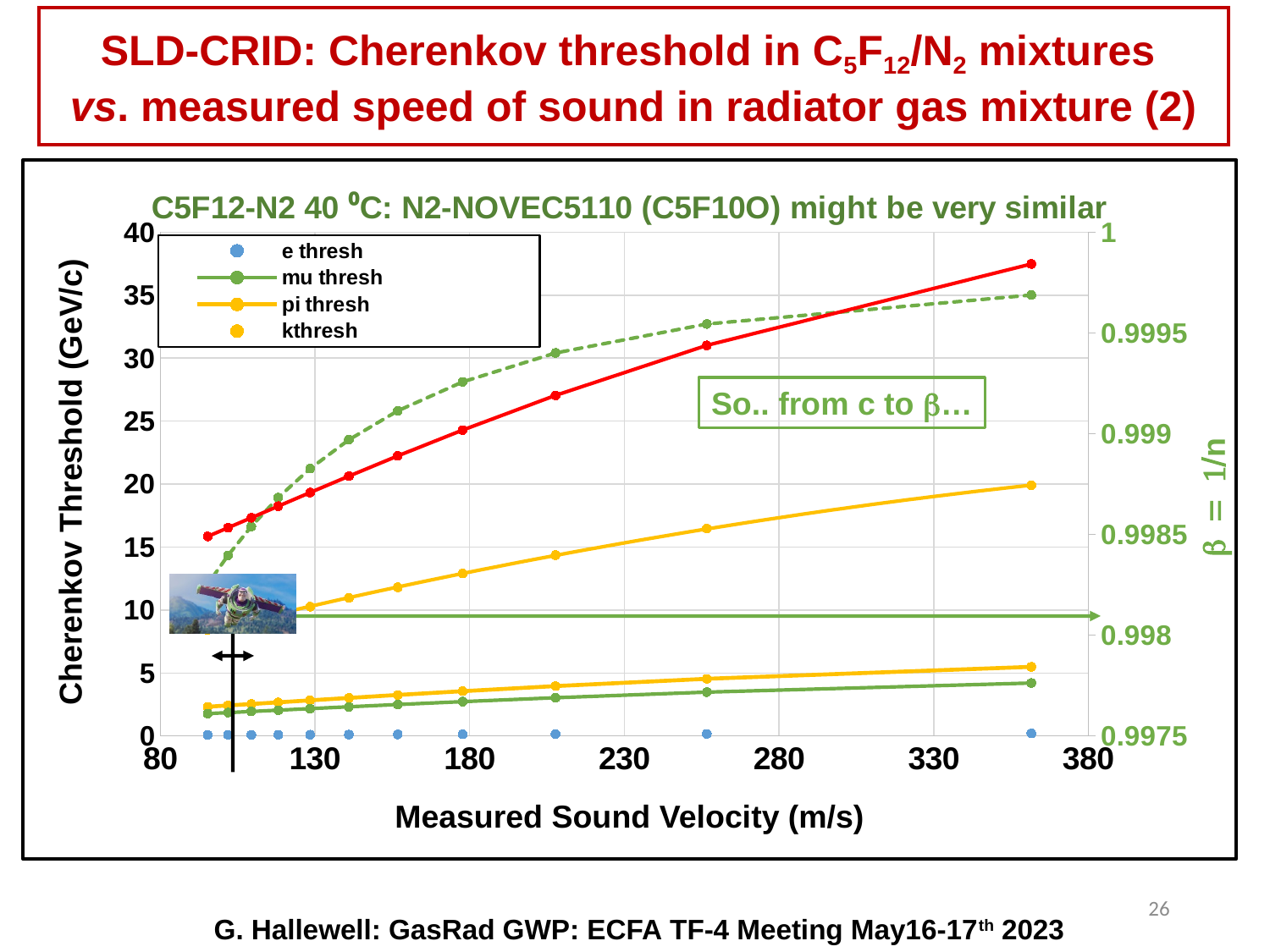
Which of the series listed in the legend has the lowest values across the chart? e thresh Which of the series listed in the legend reaches the highest value on the chart? kthresh How many series does the chart legend list? 4 Is the mu thresh value at a sound velocity of about 360 m/s greater or less than 5? less Does the pi thresh series rise or fall as measured sound velocity increases? rise Is the pi thresh value at a sound velocity of about 180 m/s greater or less than 10? less What is the title of the chart's x axis? Measured Sound Velocity (m/s) What is the title of the chart's left y axis? Cherenkov Threshold (GeV/c) At a sound velocity of about 360 m/s, which is larger, the pi thresh value or the mu thresh value? pi thresh Is the value of the red line at a sound velocity of about 210 m/s greater or less than 25? greater What kind of chart is shown on the slide? line chart